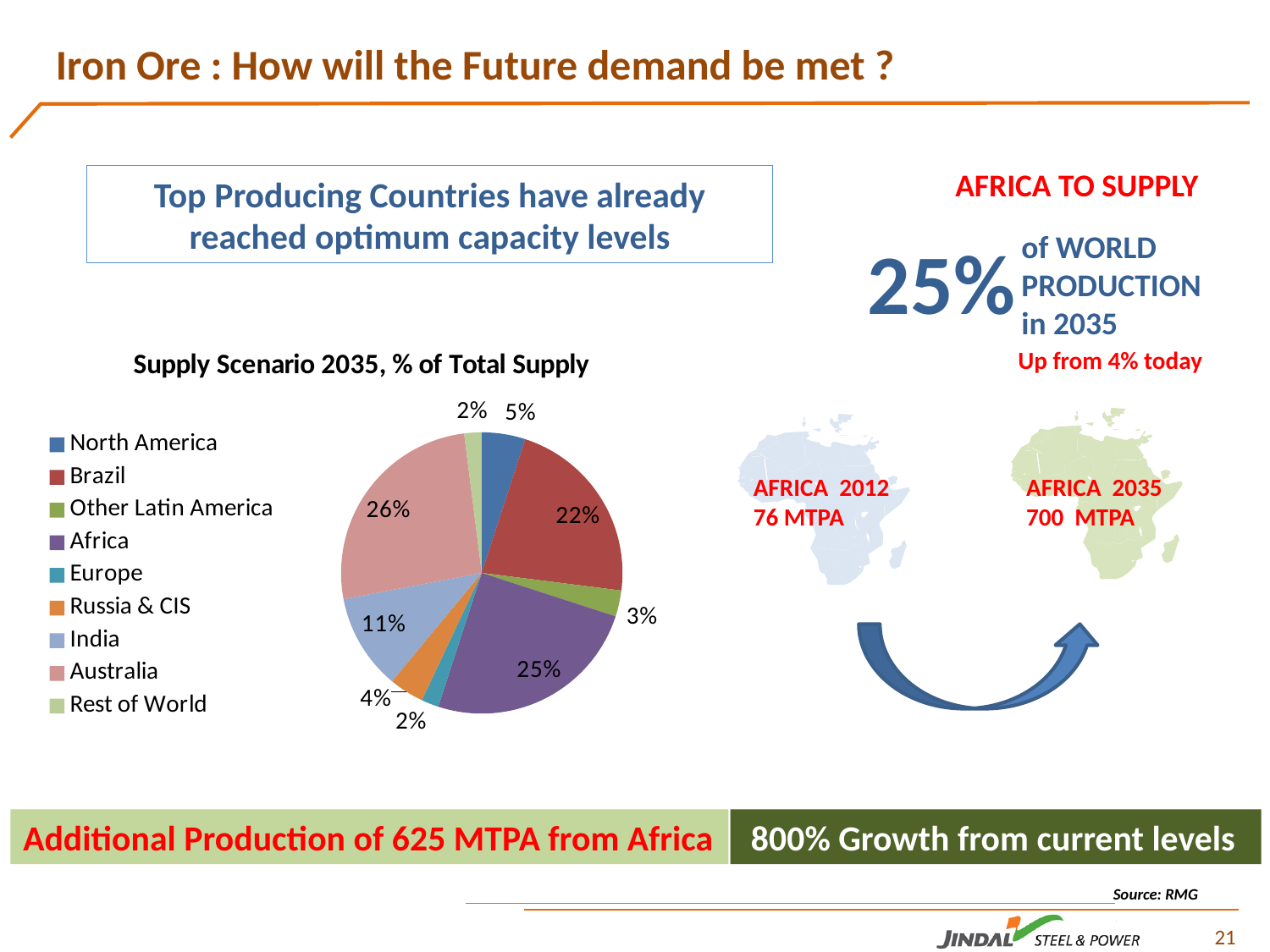
In the Supply Scenario 2035 pie chart, what is the difference between the shares of Australia and India? 15% What is the value for Australia in the Supply Scenario 2035 pie chart? 26% What is the value for India in the Supply Scenario 2035 pie chart? 11% What is the value for North America in the Supply Scenario 2035 pie chart? 5% What type of chart is shown under the title 'Supply Scenario 2035, % of Total Supply'? pie chart What is the value for Brazil in the Supply Scenario 2035 pie chart? 22% What is the title of the pie chart on the slide? Supply Scenario 2035, % of Total Supply Which region has the largest share in the Supply Scenario 2035 pie chart? Australia How many regions are listed in the legend of the Supply Scenario 2035 pie chart? 9 What is the value for Russia & CIS in the Supply Scenario 2035 pie chart? 4% In the Supply Scenario 2035 pie chart, which is larger: the share for Brazil or the share for India? Brazil What share of total supply in 2035 does Africa account for in the pie chart? 25%